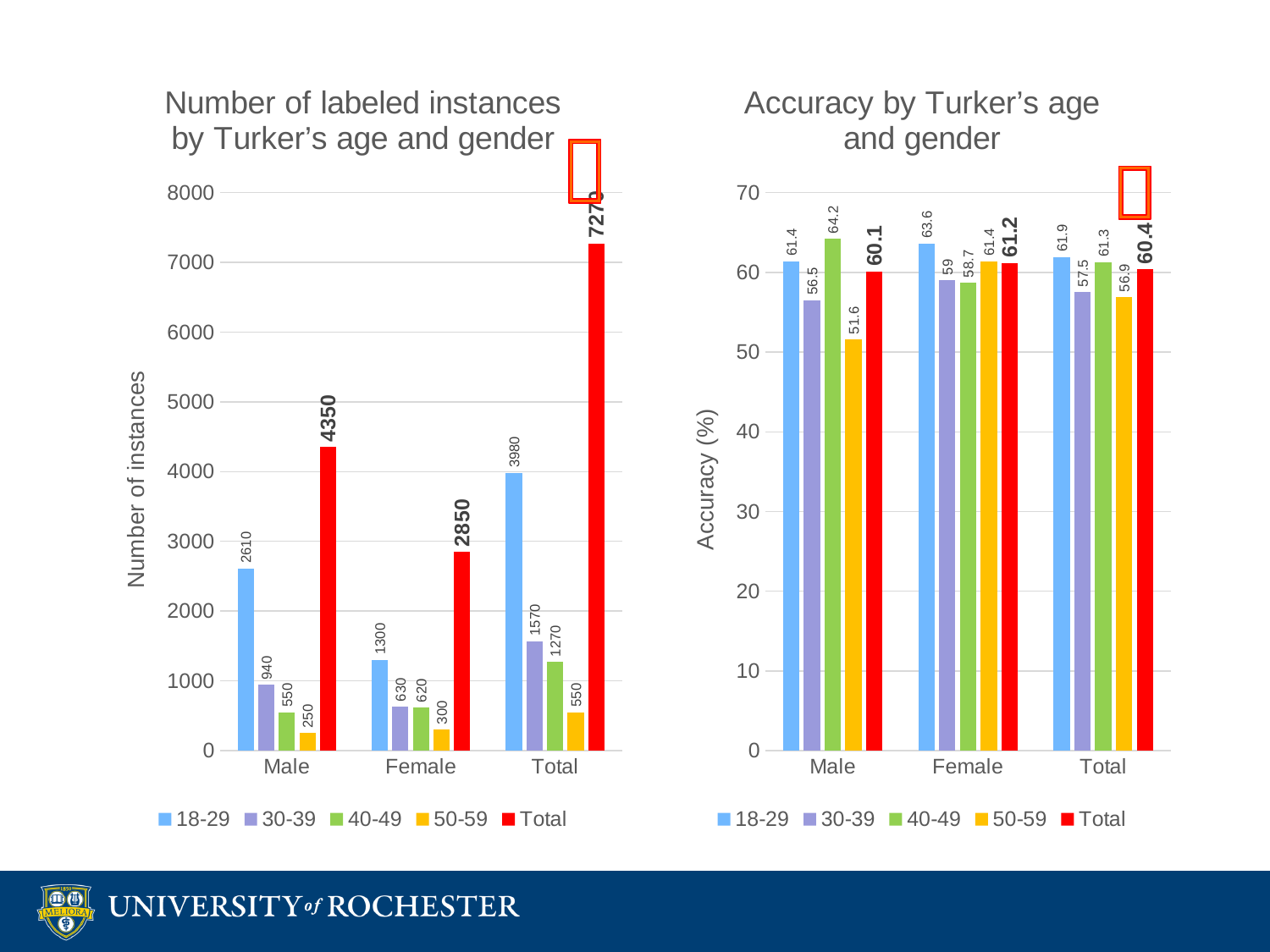
In the 'Number of labeled instances by Turker's age and gender' chart, how many series does the legend list? 5 In the 'Number of labeled instances by Turker's age and gender' chart, what is the value for the 18-29 series in the Male category? 2610 How many categories are shown on the x axis of the 'Number of labeled instances by Turker's age and gender' chart? 3 In the 'Accuracy by Turker's age and gender' chart, what is the difference between the 18-29 and 30-39 accuracies in the Total category? 4.4 In the 'Accuracy by Turker's age and gender' chart, what is the accuracy for the 40-49 series in the Male category? 64.2 In the 'Accuracy by Turker's age and gender' chart, which is larger: the 18-29 accuracy for Male or for Female? Female In the 'Number of labeled instances by Turker's age and gender' chart, which age series has the lowest value in the Male category? 50-59 In the 'Number of labeled instances by Turker's age and gender' chart, what is the Total value for the Female category? 2850 What type of chart is the chart on the right of the slide? Bar chart In the 'Accuracy by Turker's age and gender' chart, what is the Total accuracy for the Total category? 60.4 In the 'Number of labeled instances by Turker's age and gender' chart, what is the difference between the Total values for Male and Female? 1500 In the 'Accuracy by Turker's age and gender' chart, which age series has the lowest accuracy in the Male category? 50-59